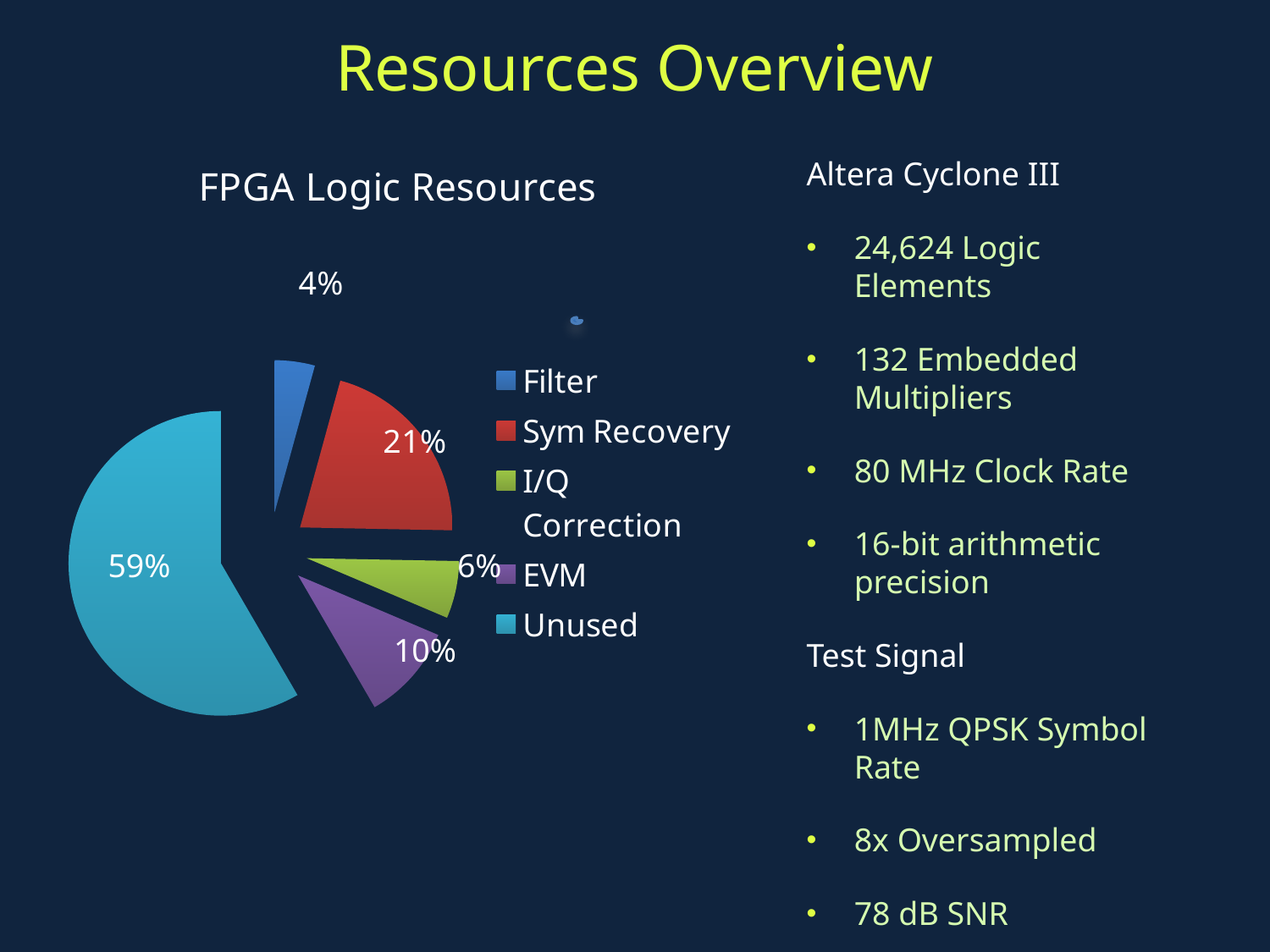
What is the title of the chart? FPGA Logic Resources What share of the pie does Sym Recovery take? 21% What share of the pie does I/Q Correction take? 6% What share of the pie does Filter take? 4% Which category has the smallest slice of the pie? Filter What kind of chart is shown on the slide? pie chart Which category has the largest slice of the pie? Unused What is the difference between the Sym Recovery share and the EVM share? 11% What share of the pie does Unused take? 59% What share of the pie does EVM take? 10% How many categories does the legend list? 5 Which is larger, the share for EVM or the share for I/Q Correction? EVM